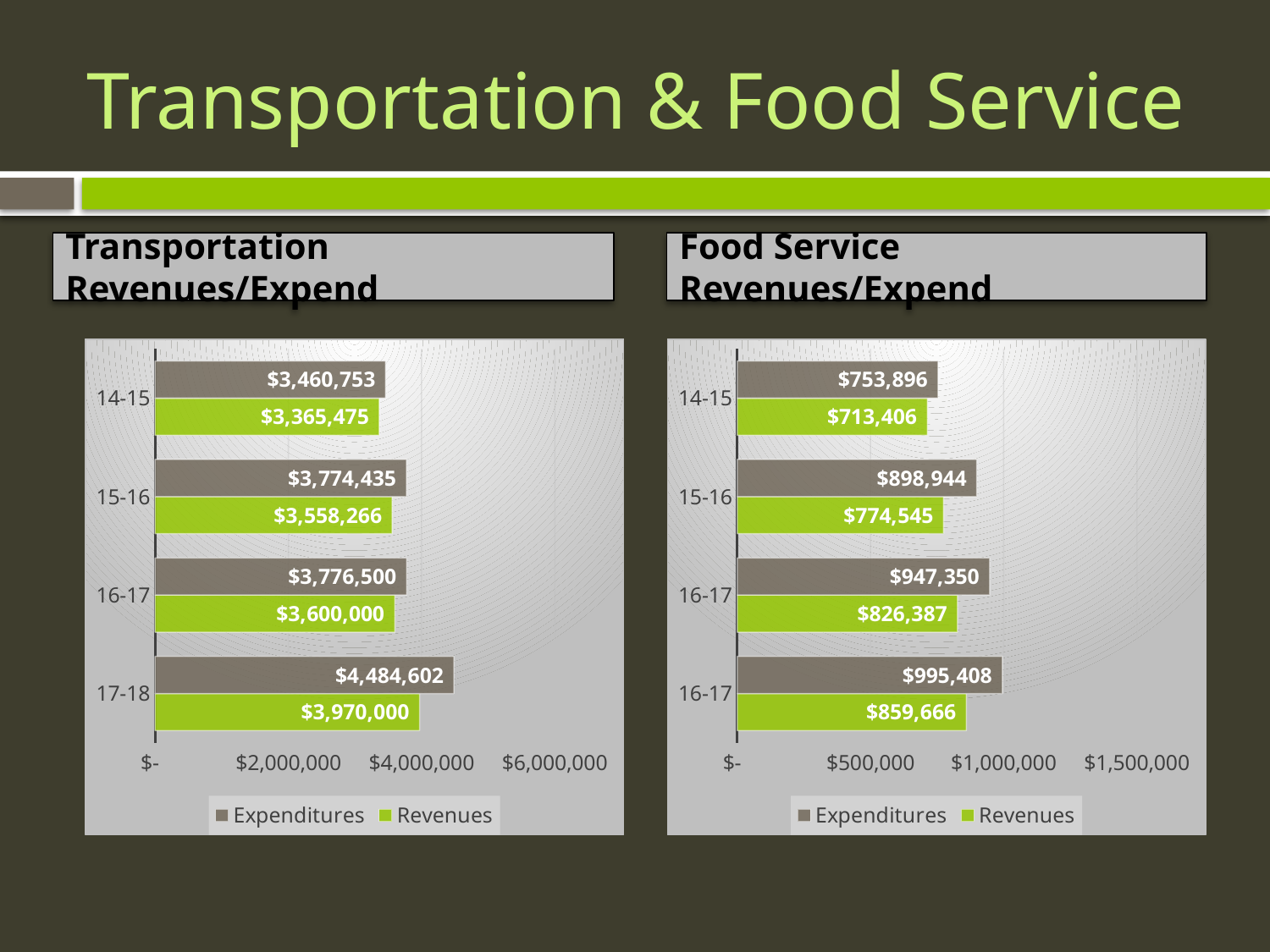
In the Food Service Revenues/Expend chart, what is the Expenditures value for 15-16? $898,944 In the Food Service Revenues/Expend chart, what is the Revenues value for 14-15? $713,406 In the Food Service Revenues/Expend chart, which year has the lowest Revenues? 14-15 In the Food Service Revenues/Expend chart, what is the difference between Expenditures and Revenues for 14-15? $40,490 In the Transportation Revenues/Expend chart, which year has the highest Expenditures? 17-18 In the Transportation Revenues/Expend chart, what is the difference between Expenditures and Revenues for 17-18? $514,602 In the Food Service Revenues/Expend chart, is the Expenditures value for 15-16 greater or less than $1,000,000? less How many series does the legend of the Transportation Revenues/Expend chart list? 2 In the Transportation Revenues/Expend chart, which is larger for 14-15, Expenditures or Revenues? Expenditures In the Transportation Revenues/Expend chart, what is the Expenditures value for 17-18? $4,484,602 In the Transportation Revenues/Expend chart, what is the Revenues value for 15-16? $3,558,266 What kind of chart is the Food Service Revenues/Expend chart? Bar chart